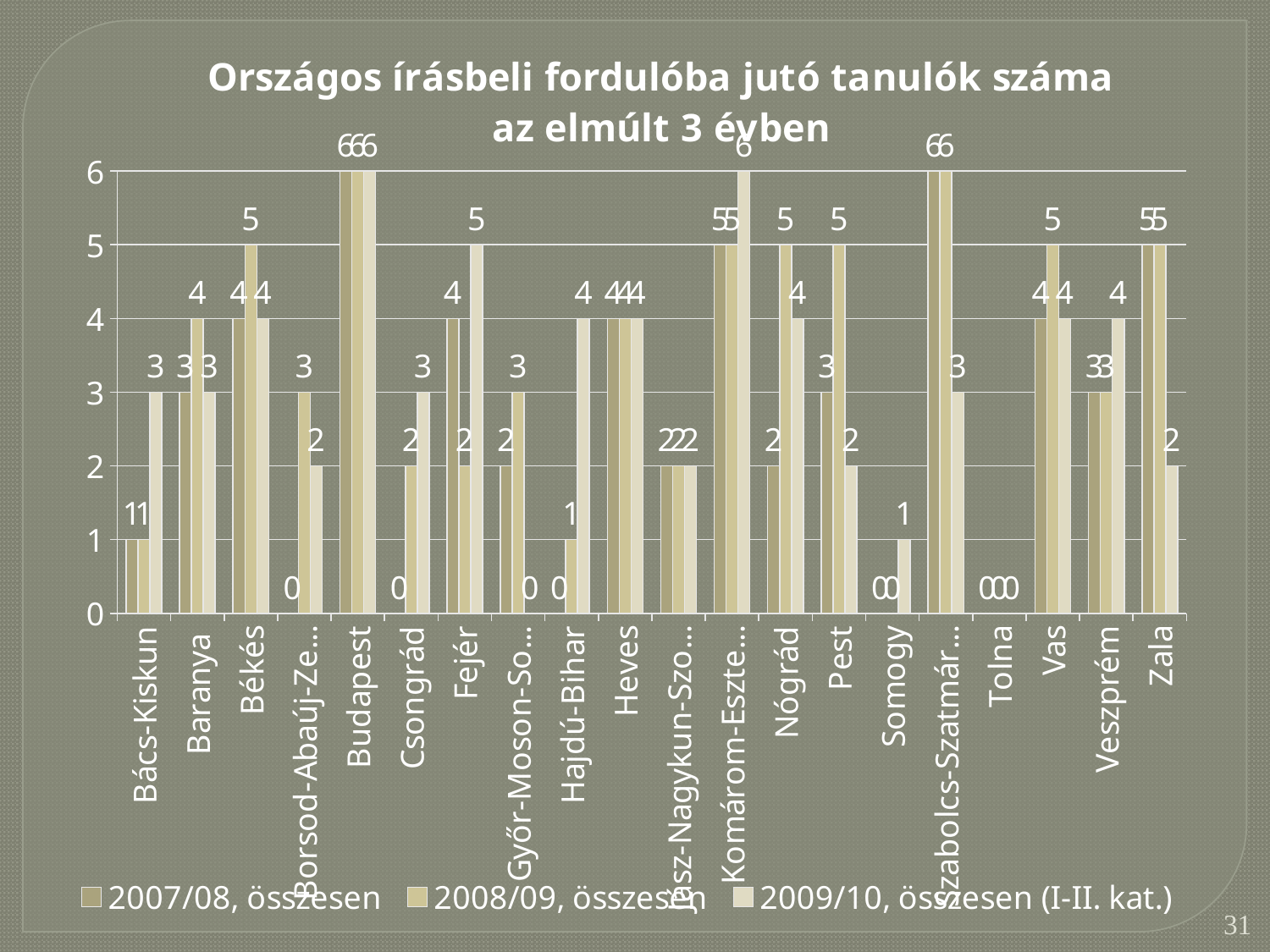
For Pest, which series has the larger value: 2008/09, összesen or 2009/10, összesen (I-II. kat.)? 2008/09, összesen What is the difference between the 2009/10 and 2008/09 values for Fejér? 3 What is the value for Budapest in the 2007/08, összesen series? 6 How many categories (counties) are shown on the x axis? 20 What is the value for Somogy in the 2009/10, összesen (I-II. kat.) series? 1 What is the value for Tolna in the 2009/10, összesen (I-II. kat.) series? 0 For Nógrád, which series has the larger value: 2007/08, összesen or 2008/09, összesen? 2008/09, összesen What is the value for Heves in the 2008/09, összesen series? 4 What is the value for Hajdú-Bihar in the 2009/10, összesen (I-II. kat.) series? 4 What is the title of the chart? Országos írásbeli fordulóba jutó tanulók száma az elmúlt 3 évben How many series does the legend list? 3 What kind of chart is shown on the slide? bar chart